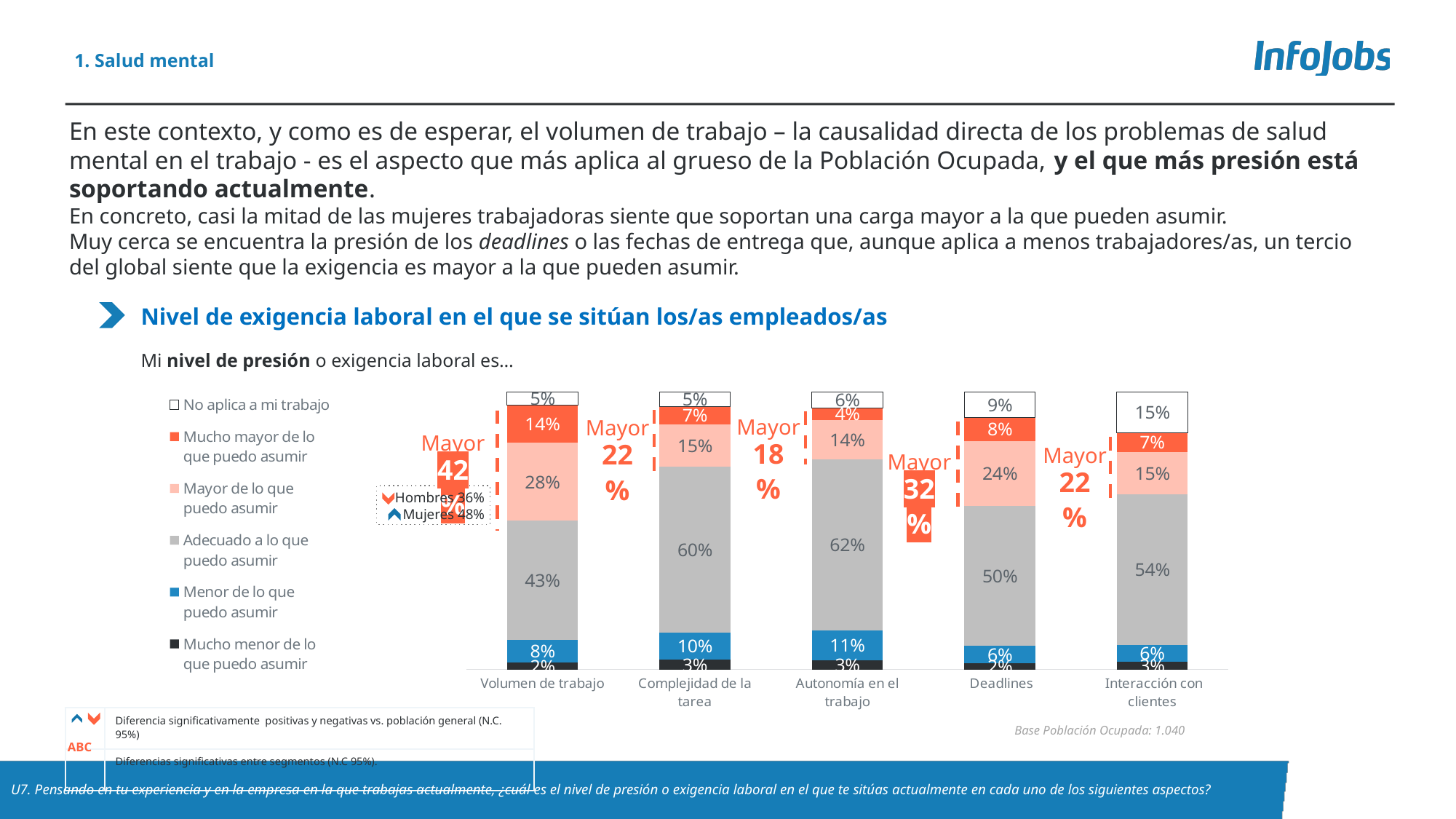
What is the "No aplica a mi trabajo" value for Interacción con clientes? 15% Which category has the highest "Adecuado a lo que puedo asumir" value? Autonomía en el trabajo How many categories are shown on the x axis of the chart? 5 According to the annotation on the chart, what is the "Mayor" percentage for Mujeres in Volumen de trabajo? 48% What kind of chart is shown on the slide? Stacked bar chart How many series does the chart legend list? 6 What is the "Mayor de lo que puedo asumir" value for Deadlines? 24% Which category has the lowest "Mucho mayor de lo que puedo asumir" value? Autonomía en el trabajo Which is larger: the "Menor de lo que puedo asumir" value for Autonomía en el trabajo or for Deadlines? Autonomía en el trabajo What percentage of respondents say their level of pressure is "Adecuado a lo que puedo asumir" for Volumen de trabajo? 43% What is the value of "Mucho mayor de lo que puedo asumir" for Volumen de trabajo? 14% What is the difference between the "Adecuado a lo que puedo asumir" values for Complejidad de la tarea and Volumen de trabajo? 17%